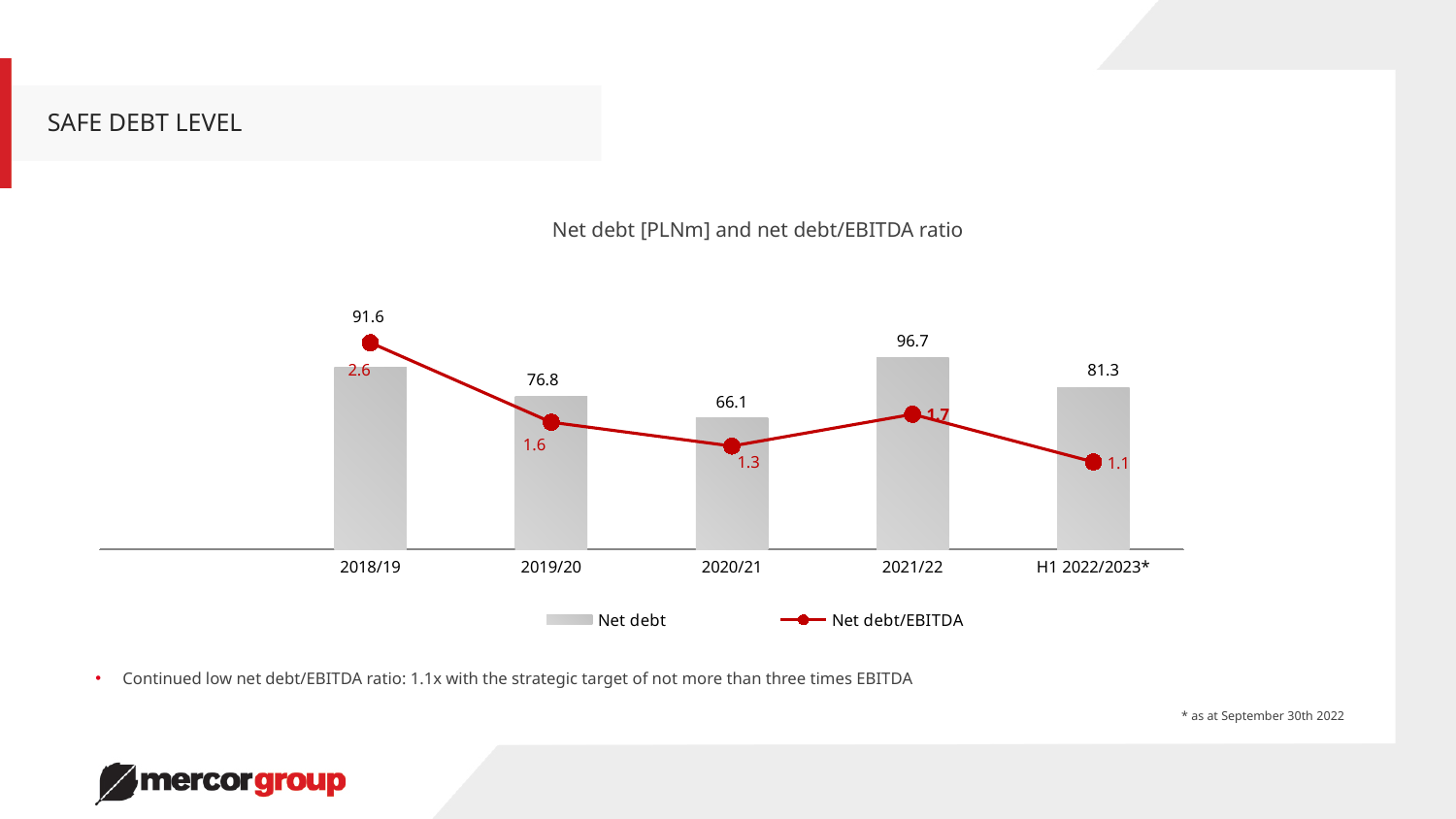
What is the net debt/EBITDA ratio for H1 2022/2023*? 1.1 Which period has the lowest net debt? 2020/21 What is the net debt/EBITDA ratio for 2018/19? 2.6 How many periods are shown on the x axis? 5 What kind of chart is this? Combined bar and line chart What is the net debt for 2021/22? 96.7 What is the difference in net debt between 2021/22 and 2020/21? 30.6 What is the title of the chart? Net debt [PLNm] and net debt/EBITDA ratio Which period has the lowest net debt/EBITDA ratio? H1 2022/2023* Which period has the highest net debt? 2021/22 Which is larger, the net debt for 2018/19 or for 2019/20? 2018/19 How many series does the legend list? 2